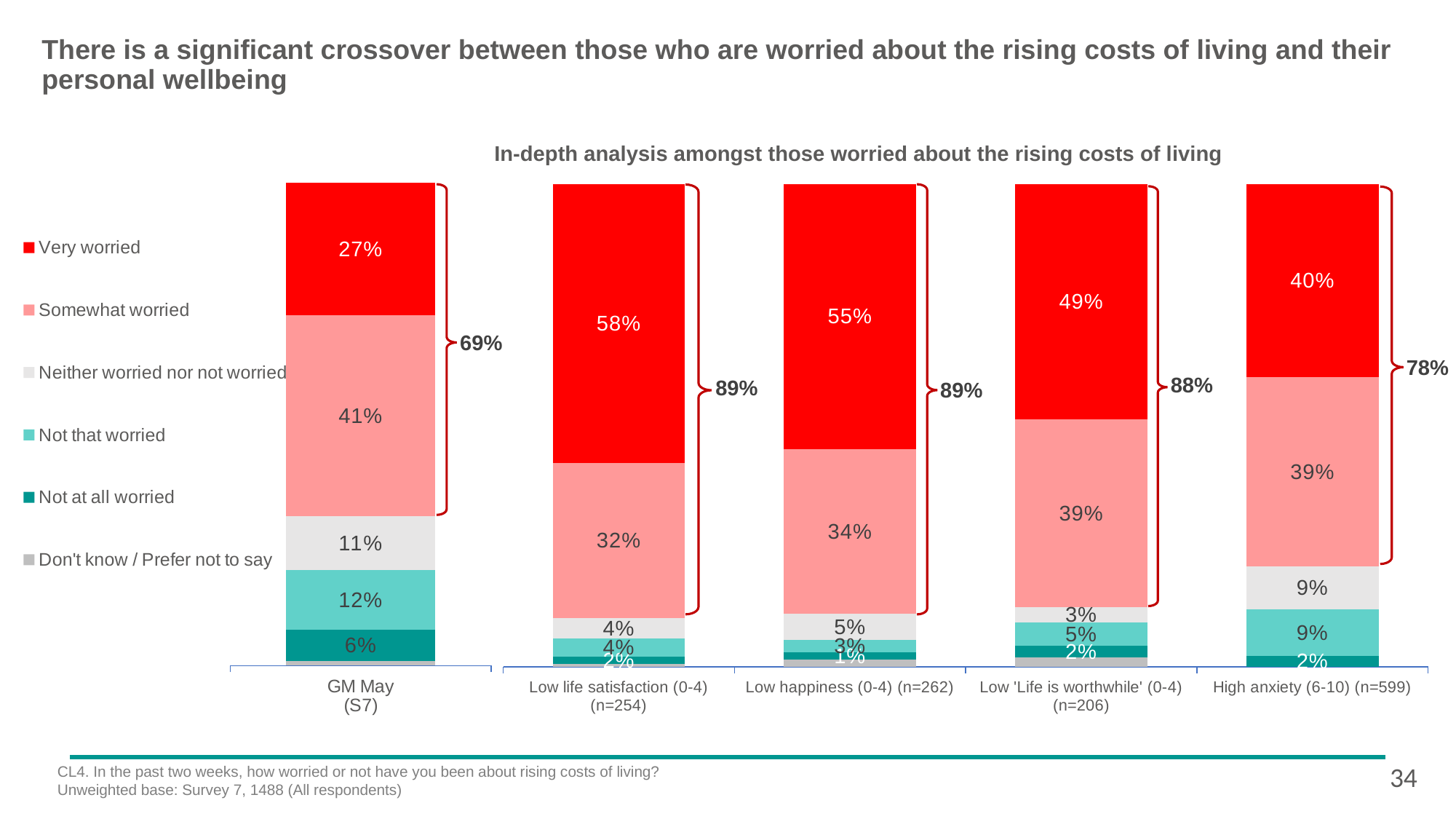
How many percentage points higher is the Very worried share for Low life satisfaction (0-4) than for High anxiety (6-10)? 18 percentage points What is the heading shown above the four right-hand bars? In-depth analysis amongst those worried about the rising costs of living What percentage of the 'Low life satisfaction (0-4) (n=254)' group is Very worried? 58% Which has a larger Somewhat worried share: GM May (S7) or Low happiness (0-4) (n=262)? GM May (S7) How many series does the legend list? 6 What combined worried percentage is shown by the bracket next to the High anxiety (6-10) (n=599) bar? 78% Which category has the highest Very worried percentage? Low life satisfaction (0-4) (n=254) What is the Somewhat worried value for GM May (S7)? 41% Which category has the lowest Very worried percentage? GM May (S7) How many bars (categories) are shown in the chart? 5 What is the Not that worried value for GM May (S7)? 12% What type of chart is shown on the slide? Stacked bar chart